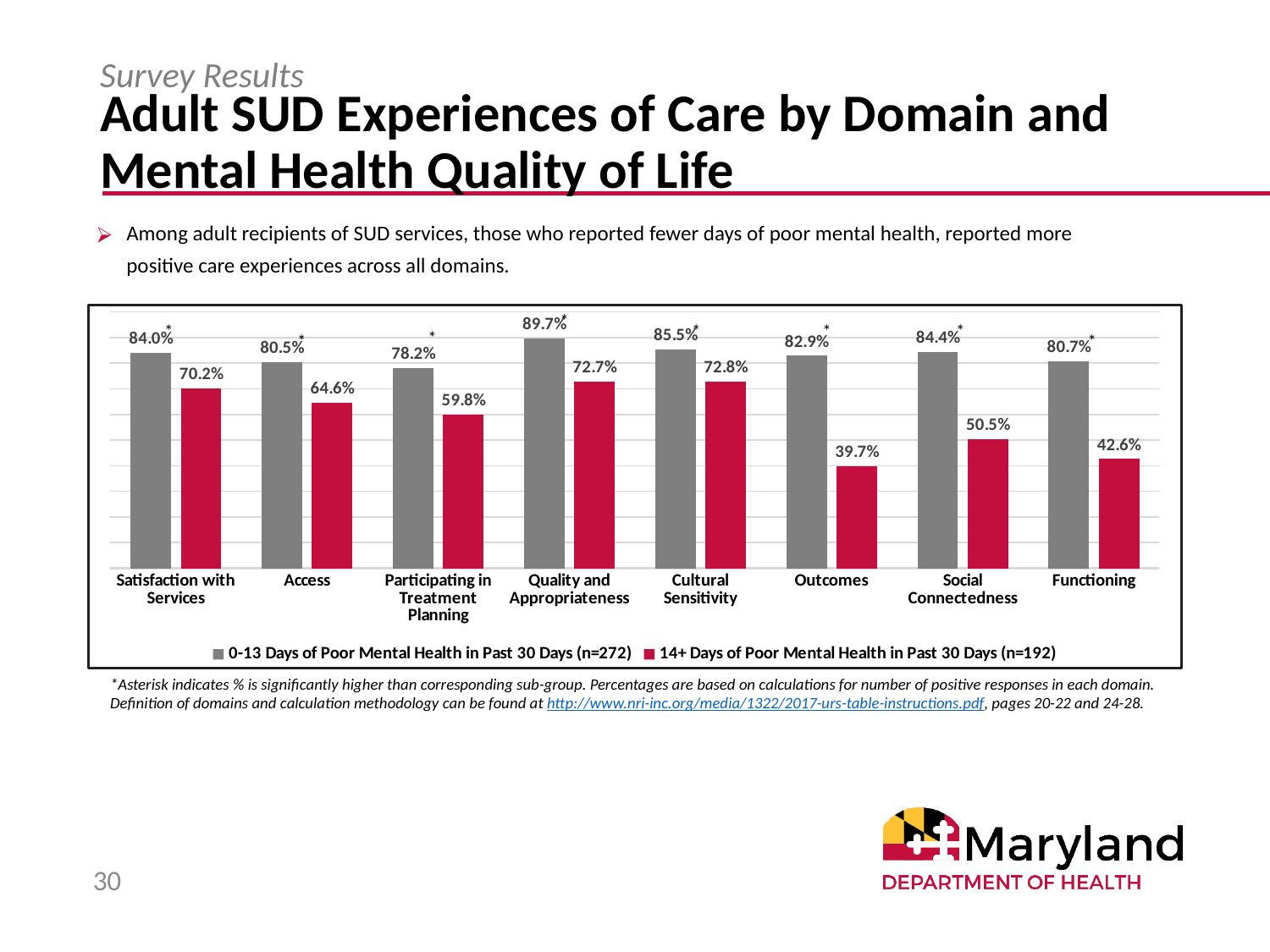
Which domain has the highest value in the 0-13 Days of Poor Mental Health in Past 30 Days series? Quality and Appropriateness What is the difference between the 0-13 Days and 14+ Days values for Satisfaction with Services? 13.8 percentage points What is the value for Social Connectedness in the 14+ Days of Poor Mental Health in Past 30 Days series? 50.5% What is the value for Participating in Treatment Planning in the 14+ Days of Poor Mental Health in Past 30 Days series? 59.8% What kind of chart is shown on the slide? Bar chart How many series does the chart's legend list? 2 What is the value for Outcomes in the 0-13 Days of Poor Mental Health in Past 30 Days series? 82.9% Which domain has the lowest value in the 14+ Days of Poor Mental Health in Past 30 Days series? Outcomes For Functioning, which series has the larger value: 0-13 Days of Poor Mental Health or 14+ Days of Poor Mental Health? 0-13 Days of Poor Mental Health in Past 30 Days What is the difference between the 0-13 Days and 14+ Days values for Outcomes? 43.2 percentage points How many domains are shown on the x axis of the chart? 8 Which domain has the lowest value in the 0-13 Days of Poor Mental Health in Past 30 Days series? Participating in Treatment Planning